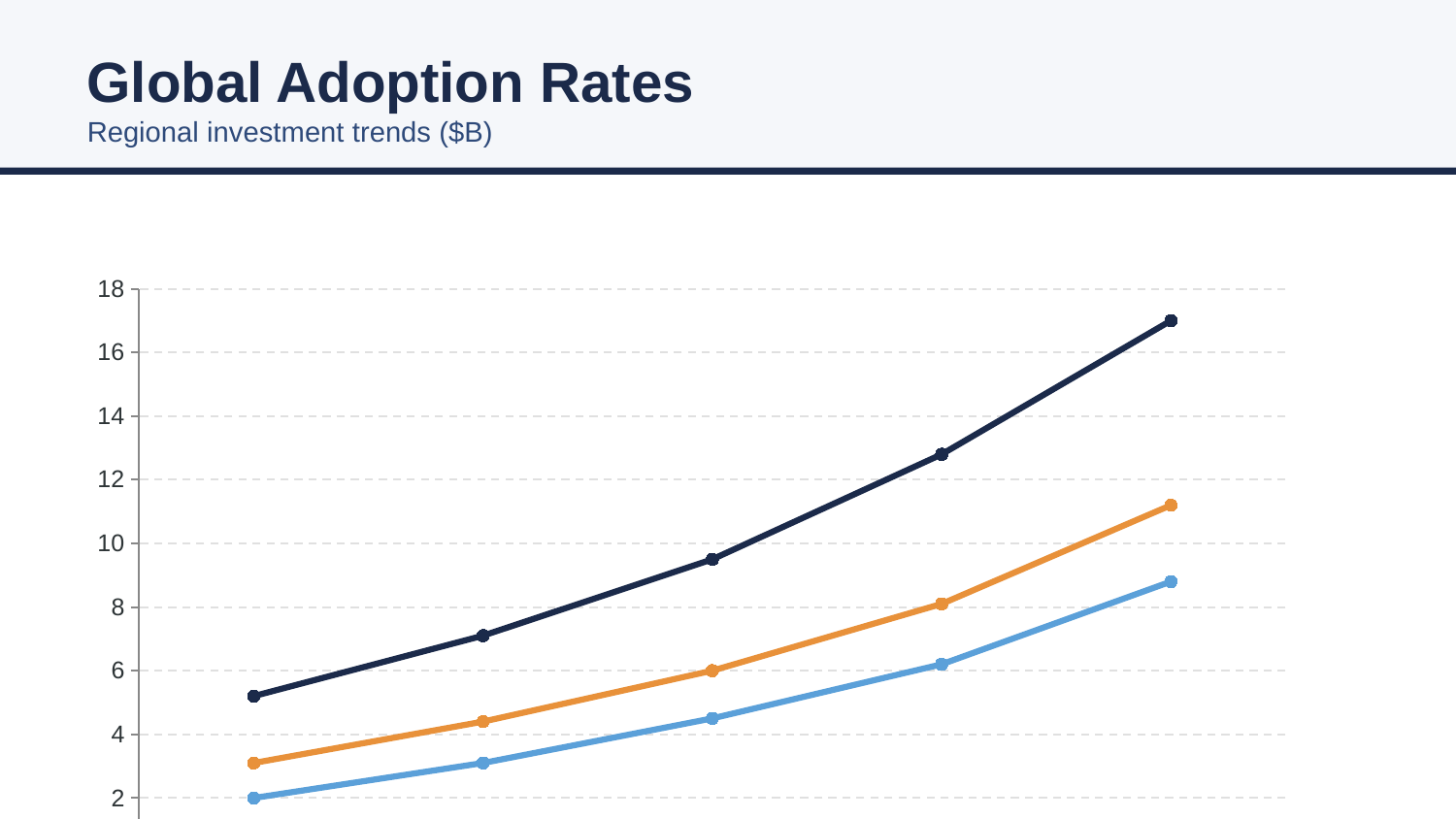
Is the final value of the dark navy line greater or less than 16? greater Is the final value of the orange line greater or less than 10? greater What kind of chart is shown on the slide? line chart Is the first value of the dark navy line greater or less than 6? less Does the dark navy line rise or fall from left to right? rise At the final point, which line is higher, the orange line or the light blue line? orange line What is the title of the slide? Global Adoption Rates How many lines are plotted on the chart? 3 How many data points does each line have? 5 Which line has the lowest values across the chart? light blue line Which line reaches the highest value at the final point? dark navy line